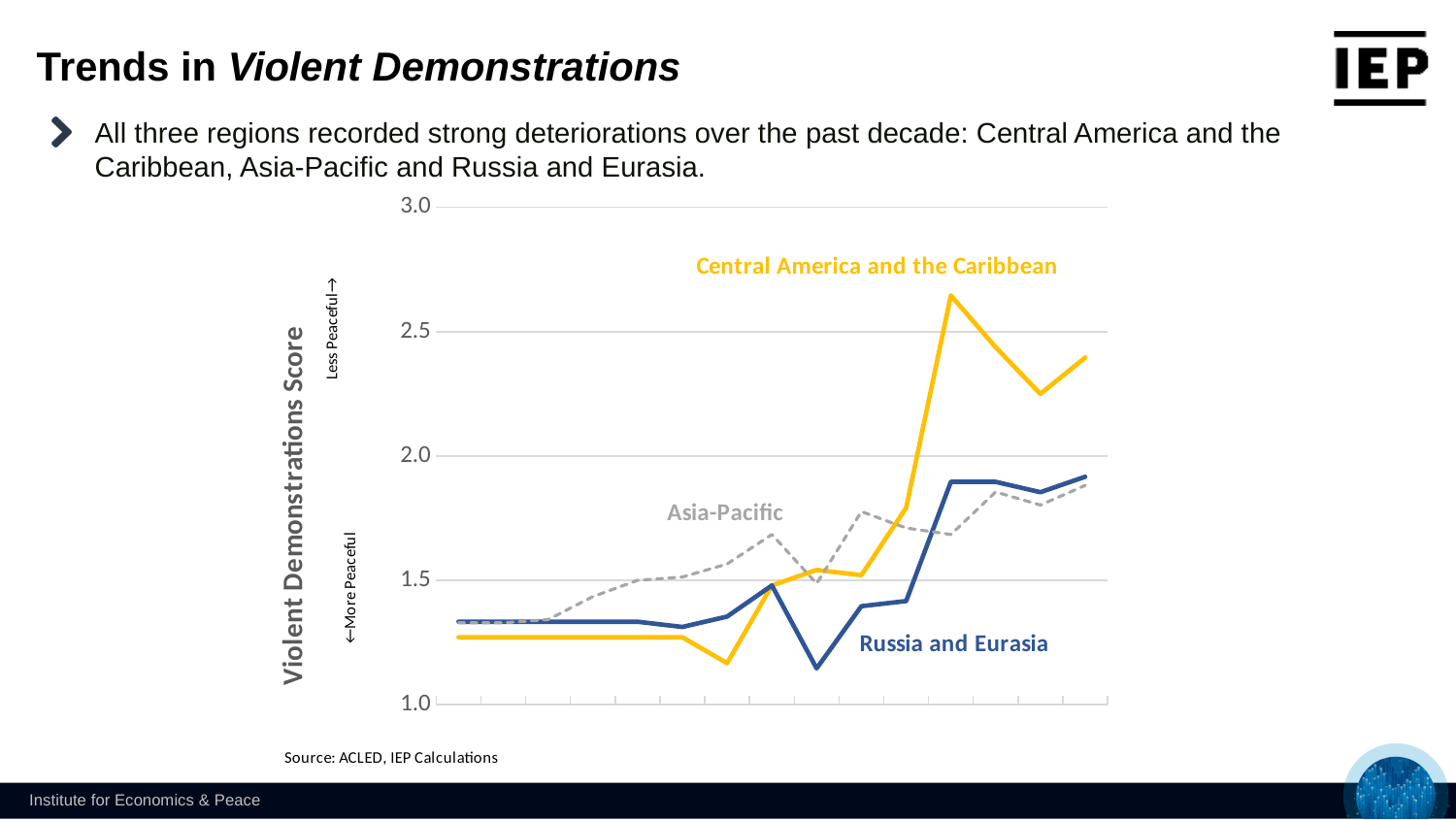
Do the Violent Demonstrations Scores for the three regions generally rise or fall from left to right? Rise Is the peak value for Central America and the Caribbean greater or less than 2.5? greater How many regions (series) are plotted on the chart? 3 Which region reaches the highest Violent Demonstrations Score on the chart? Central America and the Caribbean Is the final (rightmost) value for Asia-Pacific greater or less than 2.0? less Is the lowest value for Russia and Eurasia greater or less than 1.5? less What is the label on the vertical axis of the chart? Violent Demonstrations Score What source is cited below the chart? ACLED, IEP Calculations What kind of chart is shown on the slide? Line chart At the right end of the chart, which is higher: Central America and the Caribbean or Russia and Eurasia? Central America and the Caribbean